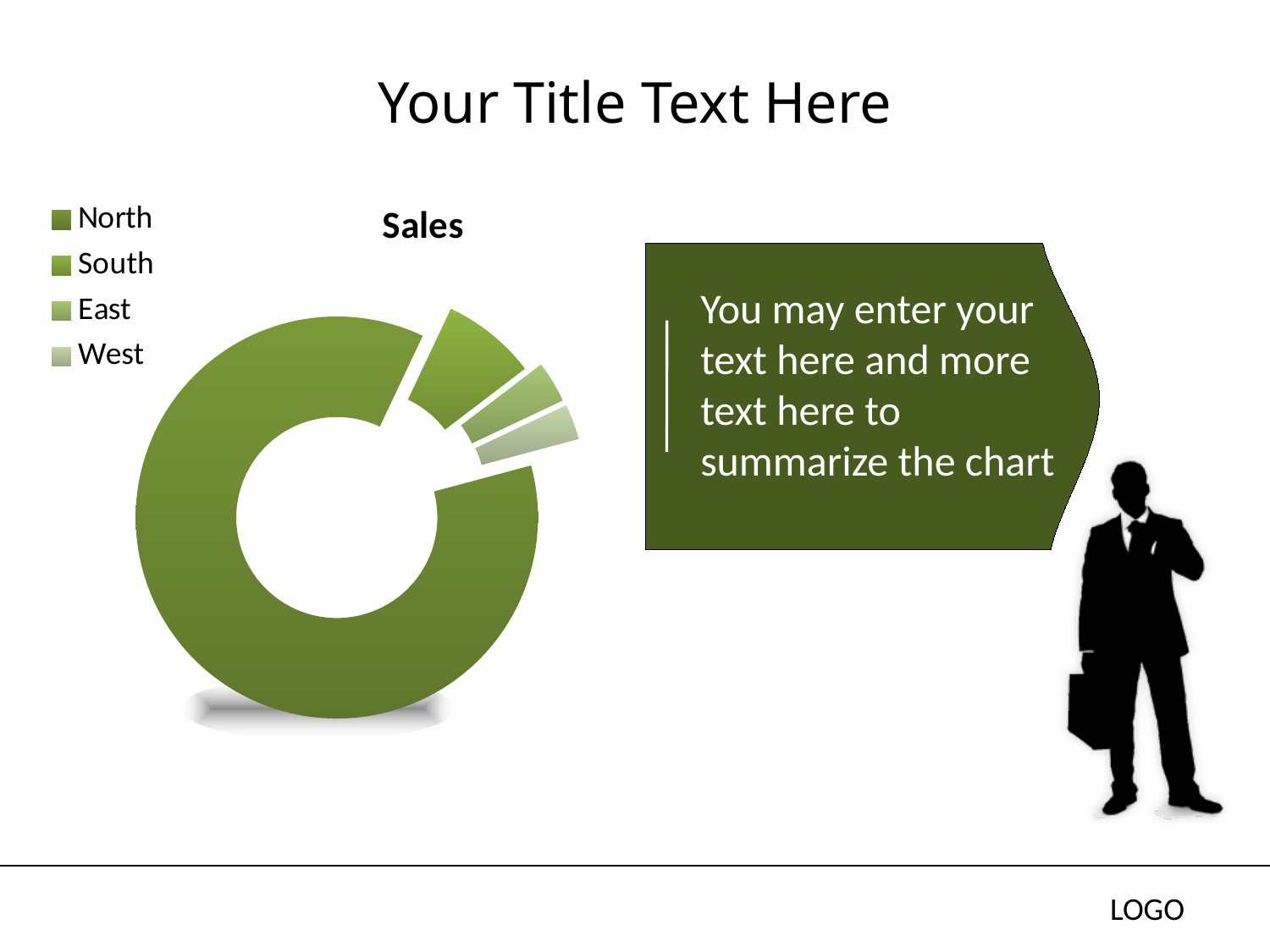
Which is larger in the Sales chart, South or East? South Which is larger in the Sales chart, South or West? South Which is larger in the Sales chart, North or West? North Does the North slice take up more or less than half of the Sales chart? more What is the title of the chart? Sales What kind of chart is shown on the slide? doughnut chart How many categories does the chart's legend list? 4 Which category is listed first in the chart's legend? North Which category has the largest share of the Sales chart? North